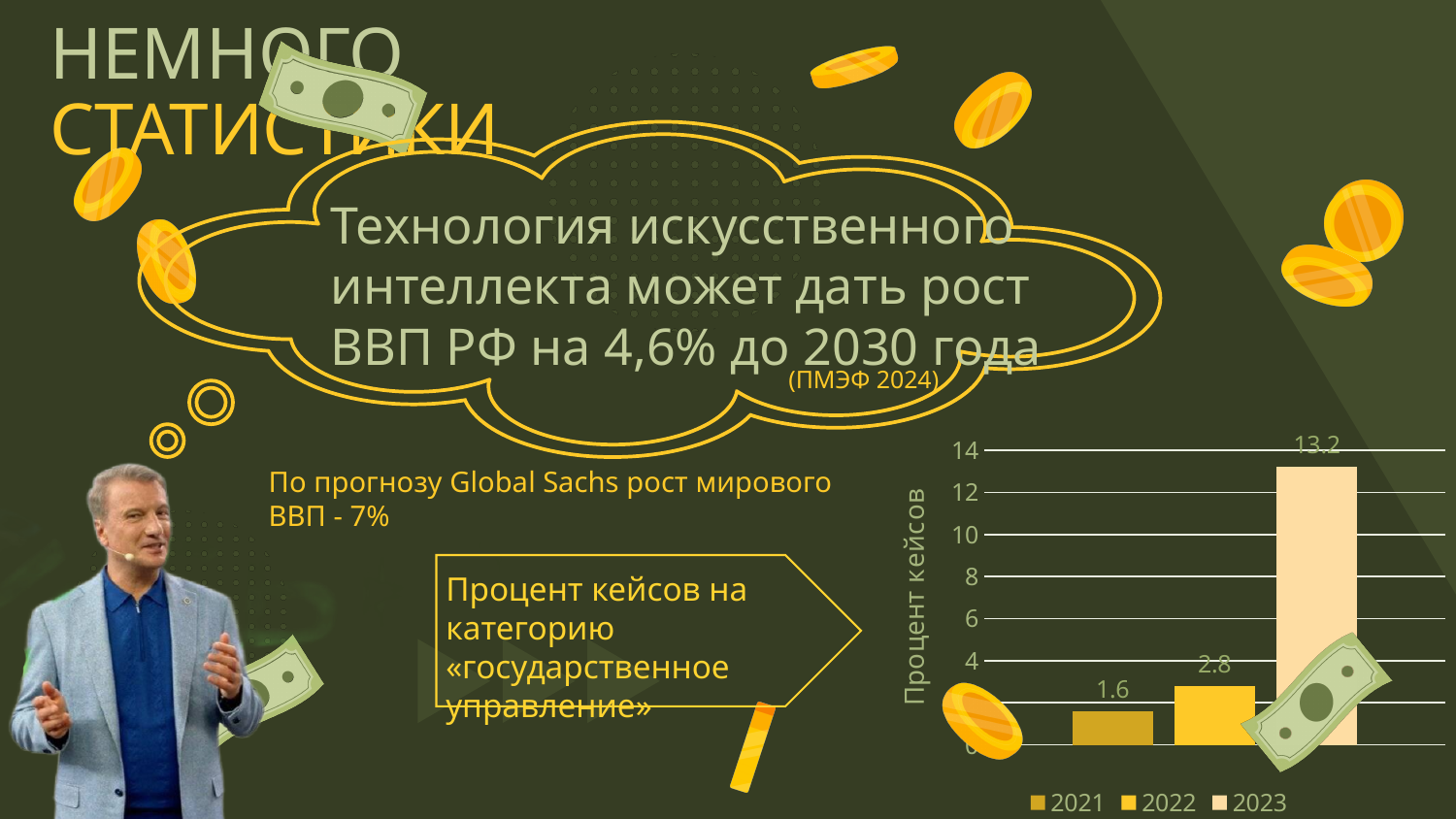
What is the difference between the values for 2022 and 2021? 1.2 Which year has the lowest value in the chart? 2021 Which year has the highest value in the chart? 2023 What kind of chart is shown on the slide? bar chart What is the value for 2023 in the chart? 13.2 How many entries does the chart legend list? 3 What is the value for 2021 in the chart? 1.6 Which is larger, the value for 2022 or the value for 2021? 2022 What is the difference between the values for 2023 and 2022? 10.4 What is the value for 2022 in the chart? 2.8 What is the label of the vertical axis of the chart? Процент кейсов Is the value for 2023 greater or less than 12? greater